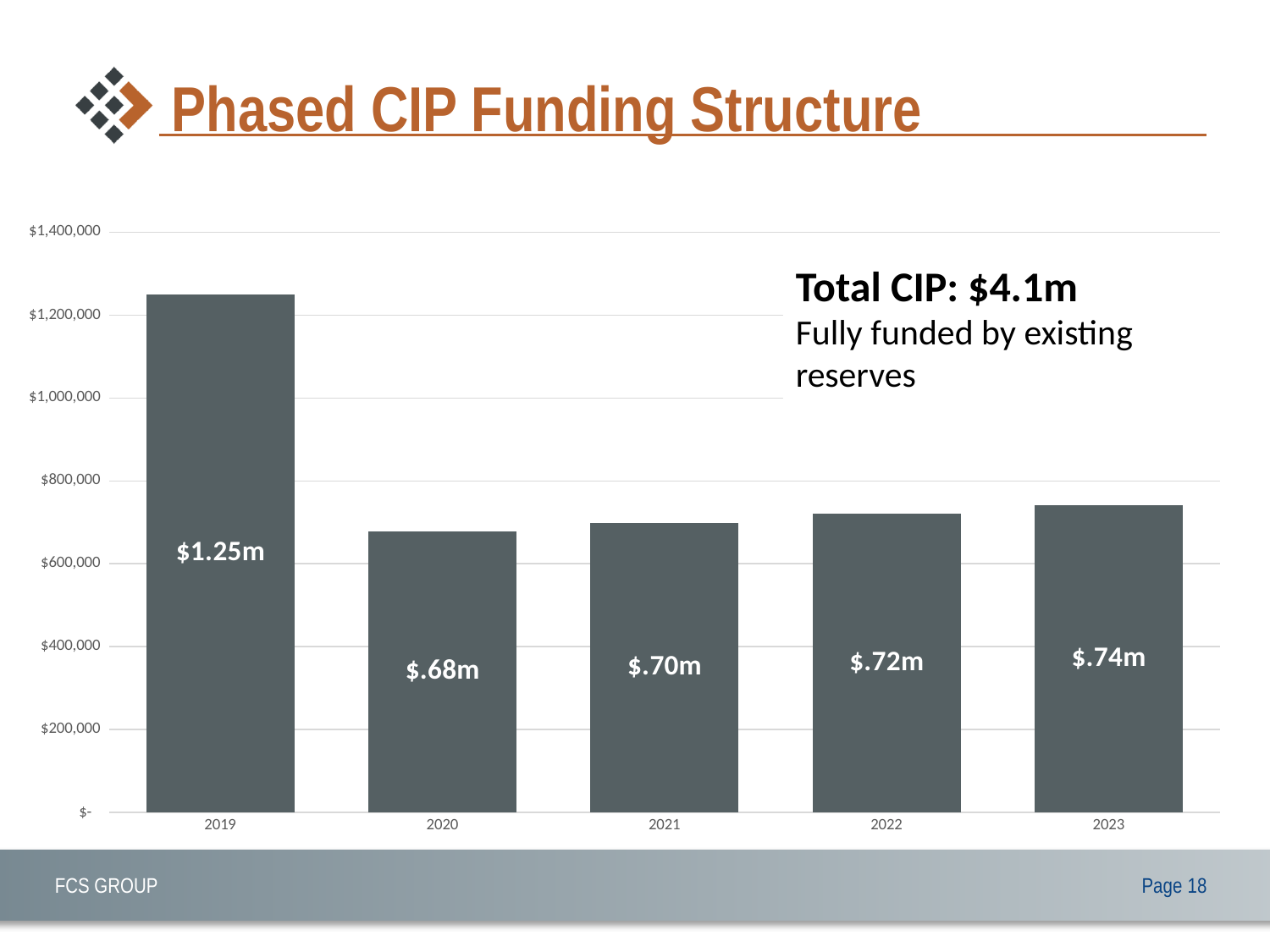
Which year has the lowest value? 2020 Which is larger, the value for 2022 or the value for 2021? 2022 What is the difference between the 2019 value and the 2020 value? $.57m What is the value for 2023? $.74m Is the value for 2019 greater or less than $1,200,000? greater What is the value for 2021? $.70m Do the values rise or fall from 2020 to 2023? rise What is the value for 2019? $1.25m What kind of chart is shown on the slide? bar chart How many years are shown on the x axis? 5 Which year has the highest value? 2019 Is the value for 2020 greater or less than $800,000? less